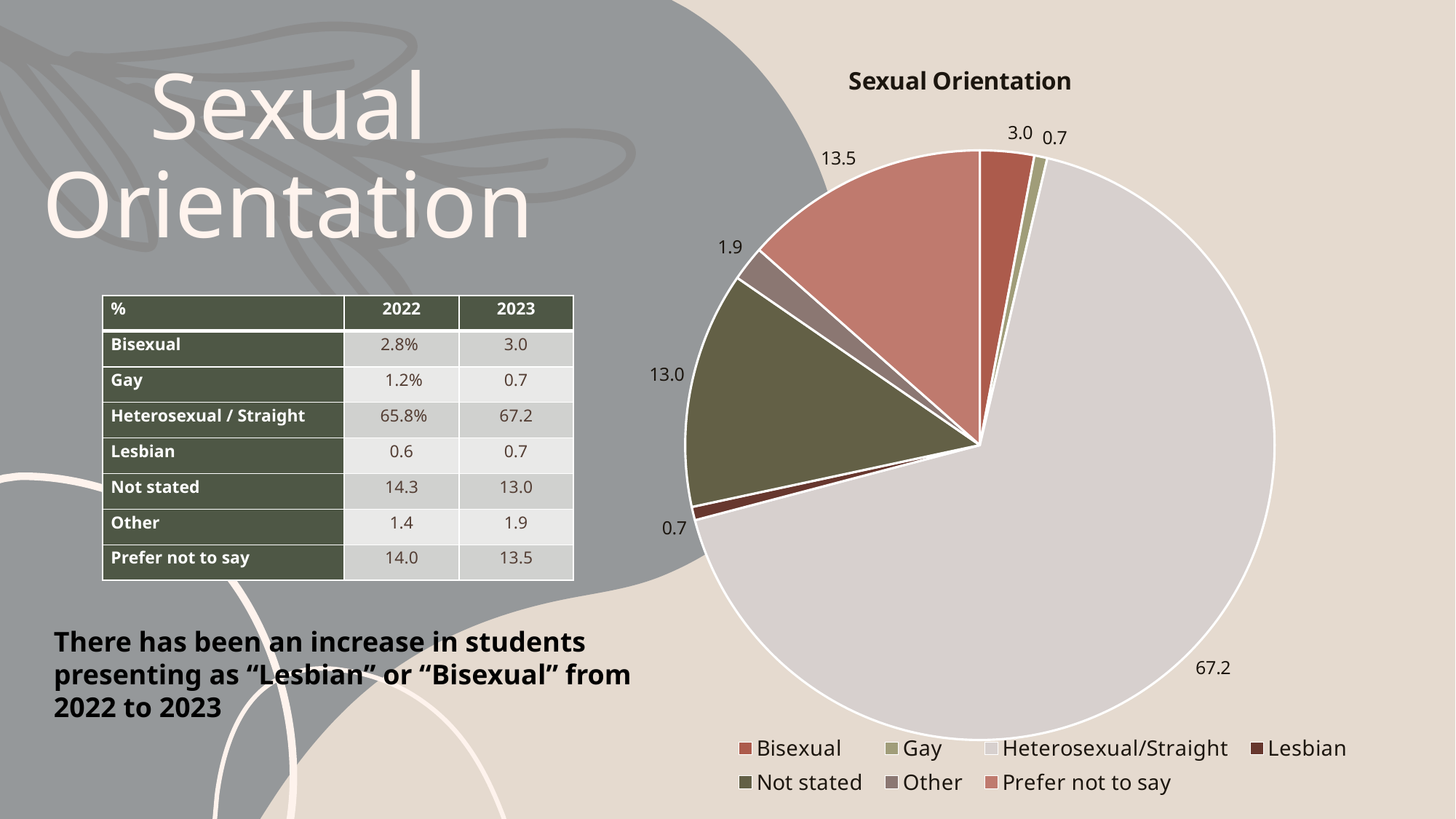
Which category has the largest slice in the pie chart? Heterosexual/Straight What is the title of the chart? Sexual Orientation What is the value shown for Not stated in the pie chart? 13.0 How many categories does the legend of the pie chart list? 7 What type of chart is shown on the slide? pie chart What is the difference between the Prefer not to say and Not stated values in the pie chart? 0.5 What is the value shown for Bisexual in the pie chart? 3.0 What is the value shown for Prefer not to say in the pie chart? 13.5 What is the difference between the Heterosexual/Straight and Prefer not to say values in the pie chart? 53.7 What is the value shown for Other in the pie chart? 1.9 What is the value shown for Heterosexual/Straight in the pie chart? 67.2 Which is larger in the pie chart, Bisexual or Other? Bisexual